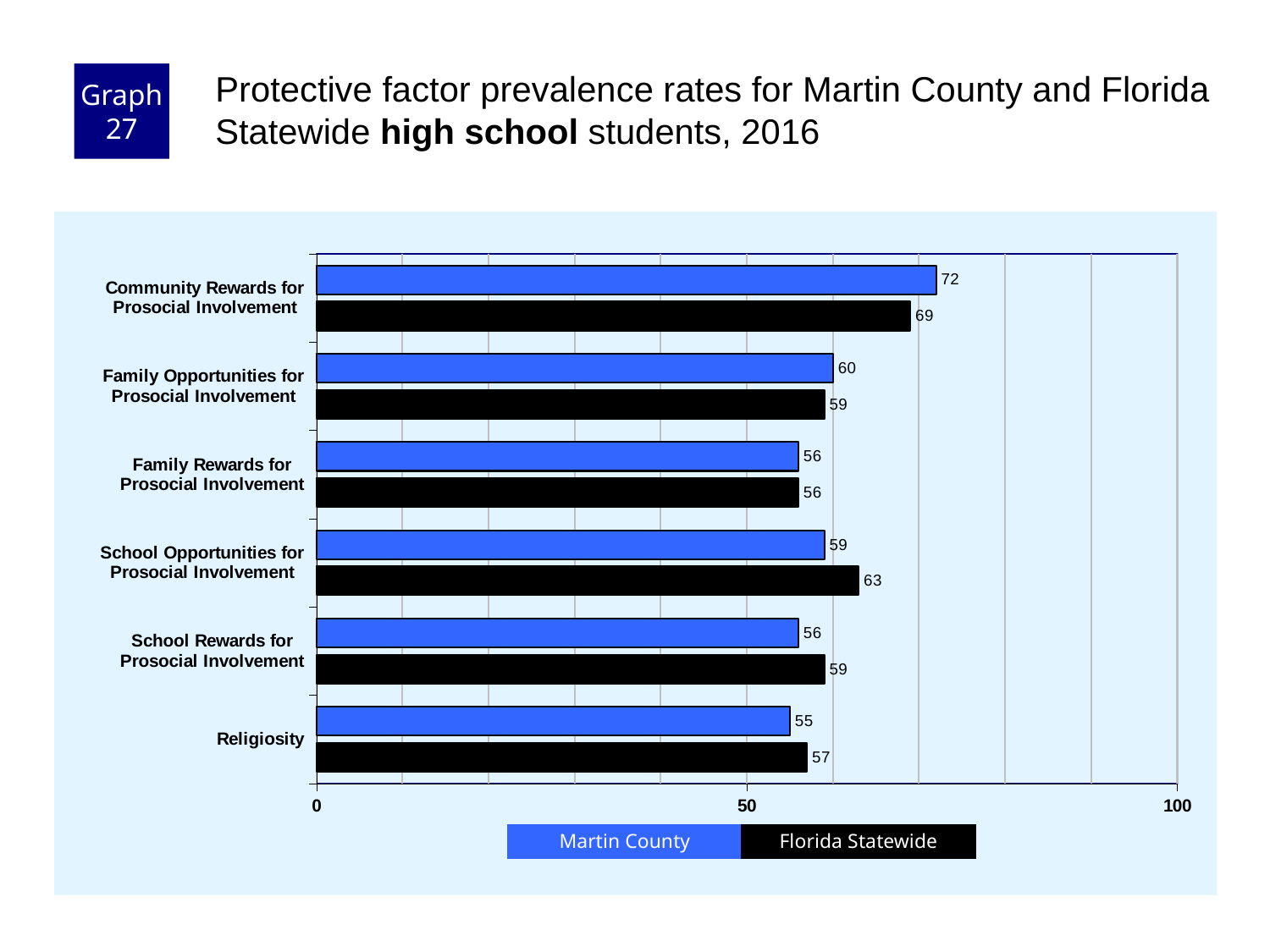
Which category has the lowest Martin County value? Religiosity What is the Martin County value for Community Rewards for Prosocial Involvement? 72 How many categories are shown on the chart? 6 What is the Florida Statewide value for School Opportunities for Prosocial Involvement? 63 For School Opportunities for Prosocial Involvement, which is larger: the Martin County value or the Florida Statewide value? Florida Statewide What kind of chart is shown on the slide? bar chart Is the Martin County value for Family Opportunities for Prosocial Involvement greater or less than 50? greater Which colour represents Florida Statewide in the chart? black How many series does the legend list? 2 What is the difference between the Martin County and Florida Statewide values for Community Rewards for Prosocial Involvement? 3 What is the Florida Statewide value for Religiosity? 57 Which category has the highest Martin County value? Community Rewards for Prosocial Involvement